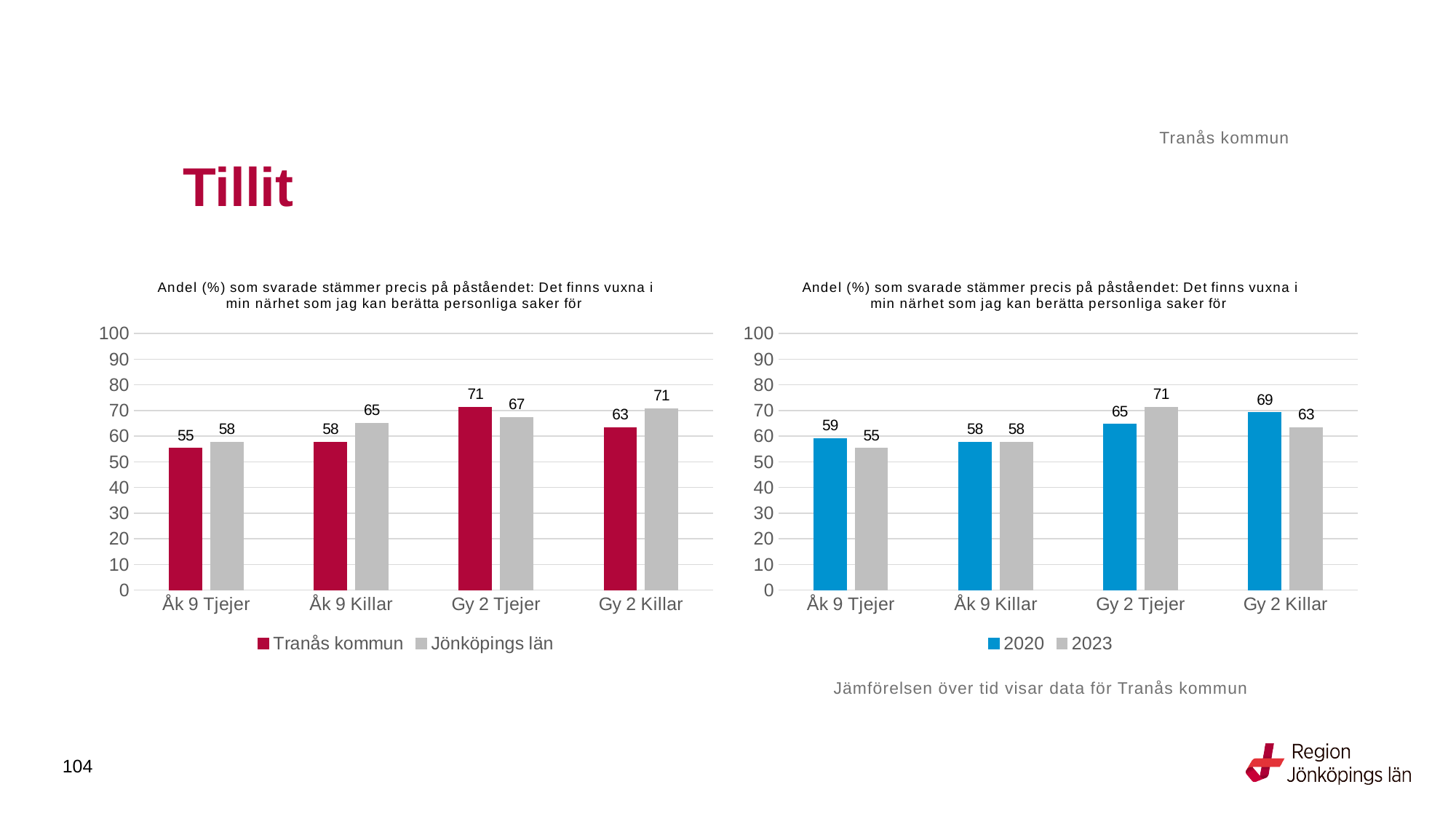
In the right chart, which is larger for Gy 2 Killar: 2020 or 2023? 2020 In the left chart, which category has the highest value for Tranås kommun? Gy 2 Tjejer In the right chart, what is the difference between 2020 and 2023 for Gy 2 Tjejer? 6 How many series does the legend of the right chart list? 2 In the right chart, which category has the lowest value for 2023? Åk 9 Tjejer In the right chart, what is the value for 2023 for Åk 9 Tjejer? 55 In the left chart, what is the difference between Jönköpings län and Tranås kommun for Gy 2 Killar? 8 In the left chart, what is the value for Tranås kommun for Gy 2 Tjejer? 71 What kind of chart is the left chart? Bar chart How many categories are shown on the x axis of the left chart? 4 In the left chart, what is the value for Jönköpings län for Åk 9 Killar? 65 In the right chart, what is the value for 2020 for Gy 2 Killar? 69